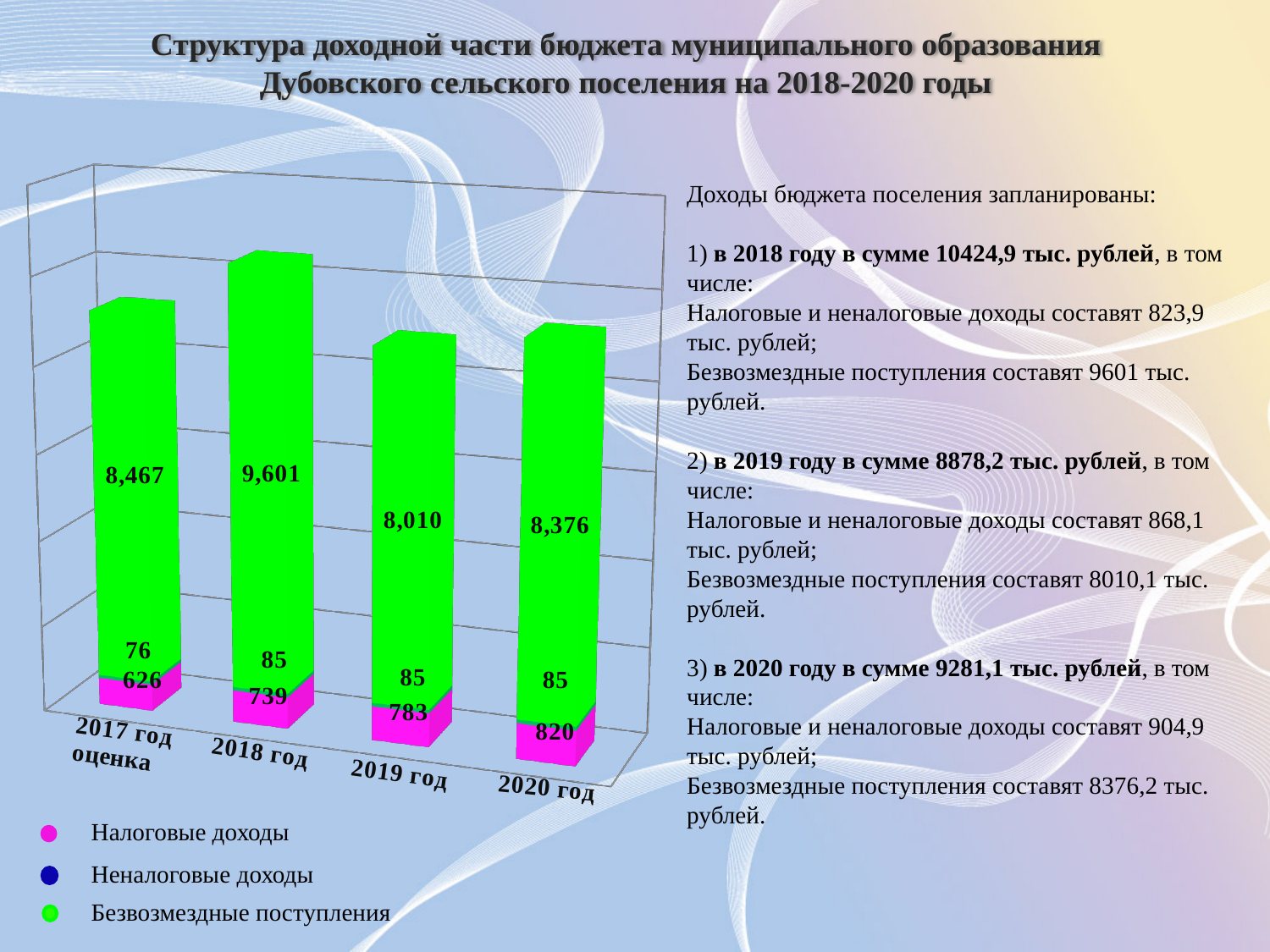
What is the difference between Налоговые доходы in 2020 год and in 2017 год оценка? 194 What colour represents Безвозмездные поступления in the chart legend? Green In which year is the value of Безвозмездные поступления the highest? 2018 год What is the value of Налоговые доходы for 2020 год? 820 How many year categories are plotted along the x axis of the chart? 4 What kind of chart is shown on the slide? Stacked bar chart How many series does the chart legend list? 3 What is the value of Безвозмездные поступления for 2018 год? 9,601 What is the value of Неналоговые доходы for 2017 год оценка? 76 In which year is the value of Безвозмездные поступления the lowest? 2019 год Do the values of Налоговые доходы rise or fall from 2017 год оценка to 2020 год? Rise Which year has the larger value of Безвозмездные поступления, 2019 год or 2020 год? 2020 год